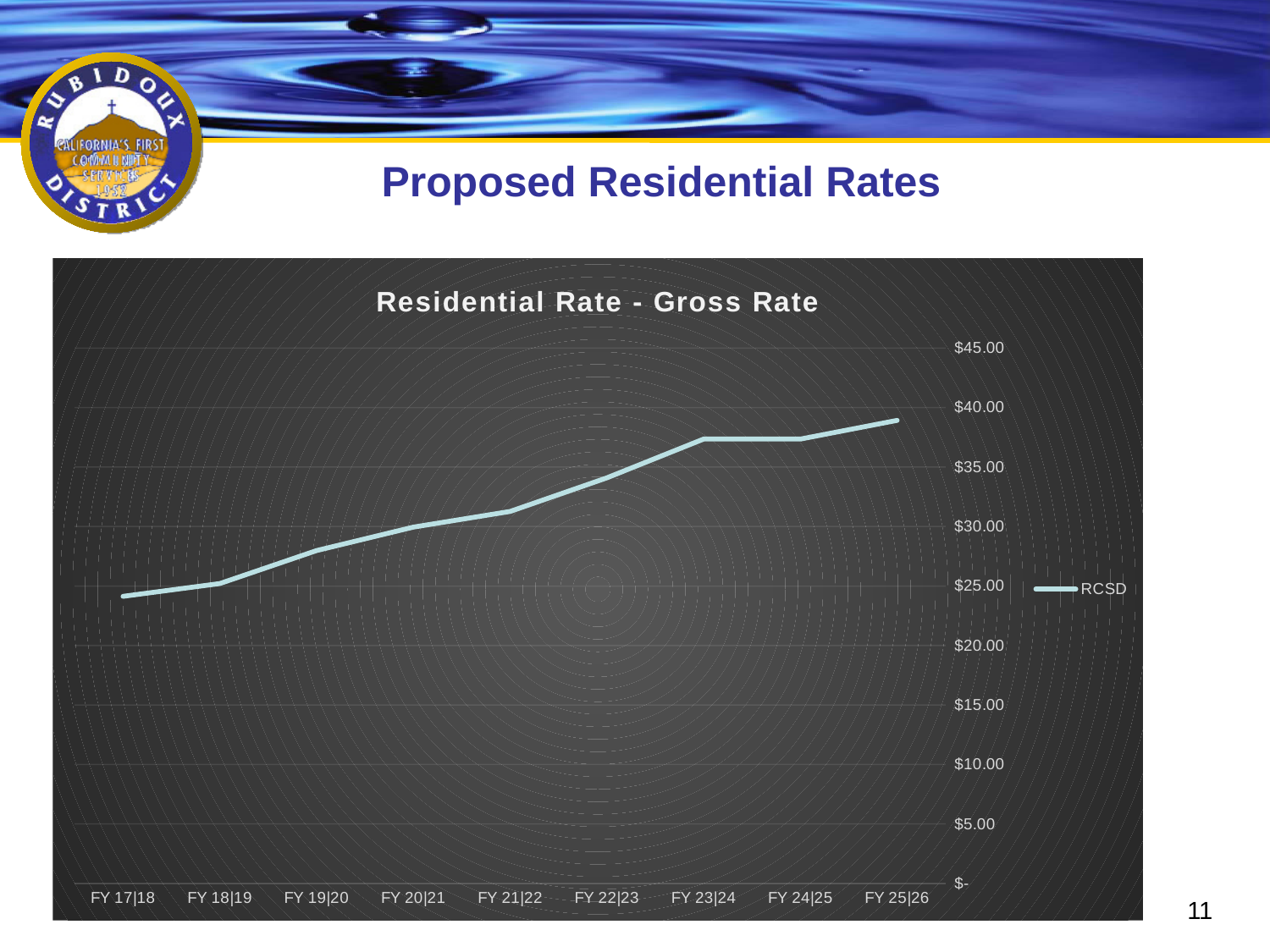
Which fiscal year has the lowest residential rate? FY 17|18 How many fiscal years are plotted along the x axis? 9 What kind of chart is shown on the slide? line chart Which is larger, the value for FY 22|23 or the value for FY 19|20? FY 22|23 Is the value for FY 23|24 greater or less than $35.00? greater What is the name of the series shown in the legend? RCSD How many series does the legend list? 1 What is the title of the chart? Residential Rate - Gross Rate Which fiscal year has the highest residential rate? FY 25|26 Is the value for FY 25|26 greater or less than $40.00? less Do the residential rates generally rise or fall from FY 17|18 to FY 25|26? rise Is the value for FY 19|20 greater or less than $25.00? greater